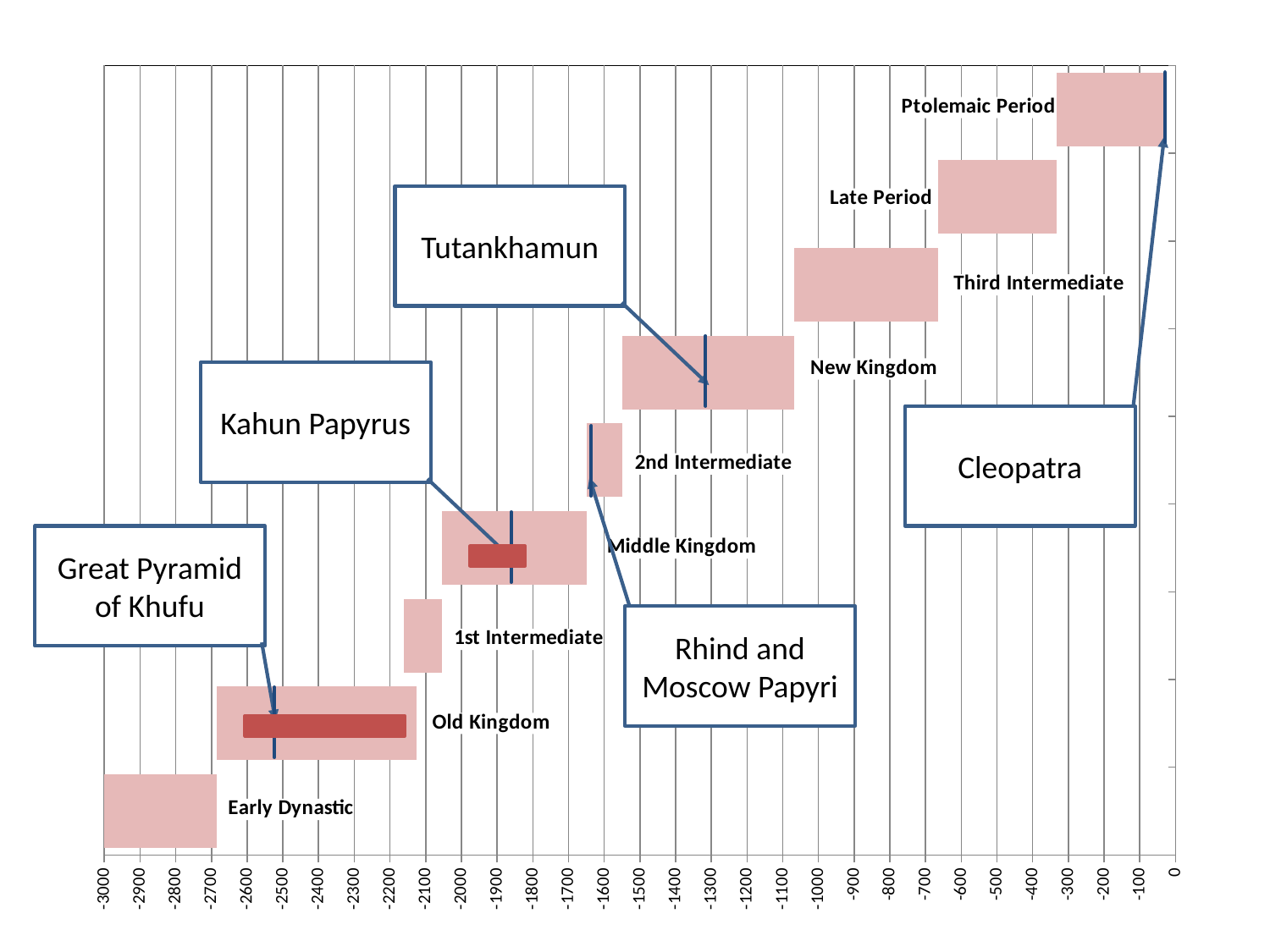
How many Egyptian periods are labelled on the chart? 9 What is the leftmost value shown on the x axis? -3000 Which bar is longer, Old Kingdom or 1st Intermediate? Old Kingdom What is the rightmost value shown on the x axis? 0 Which period's bar is the earliest (leftmost) on the timeline? Early Dynastic Does the Old Kingdom bar start before or after -2500 on the x axis? before Which period's bar is the latest (rightmost) on the timeline? Ptolemaic Period Which annotation box points to the New Kingdom bar? Tutankhamun Which bar is longer, New Kingdom or 2nd Intermediate? New Kingdom What kind of chart is shown on the slide? bar chart Does the Ptolemaic Period bar end before or after -100 on the x axis? after Which annotation box points to the Old Kingdom bar? Great Pyramid of Khufu